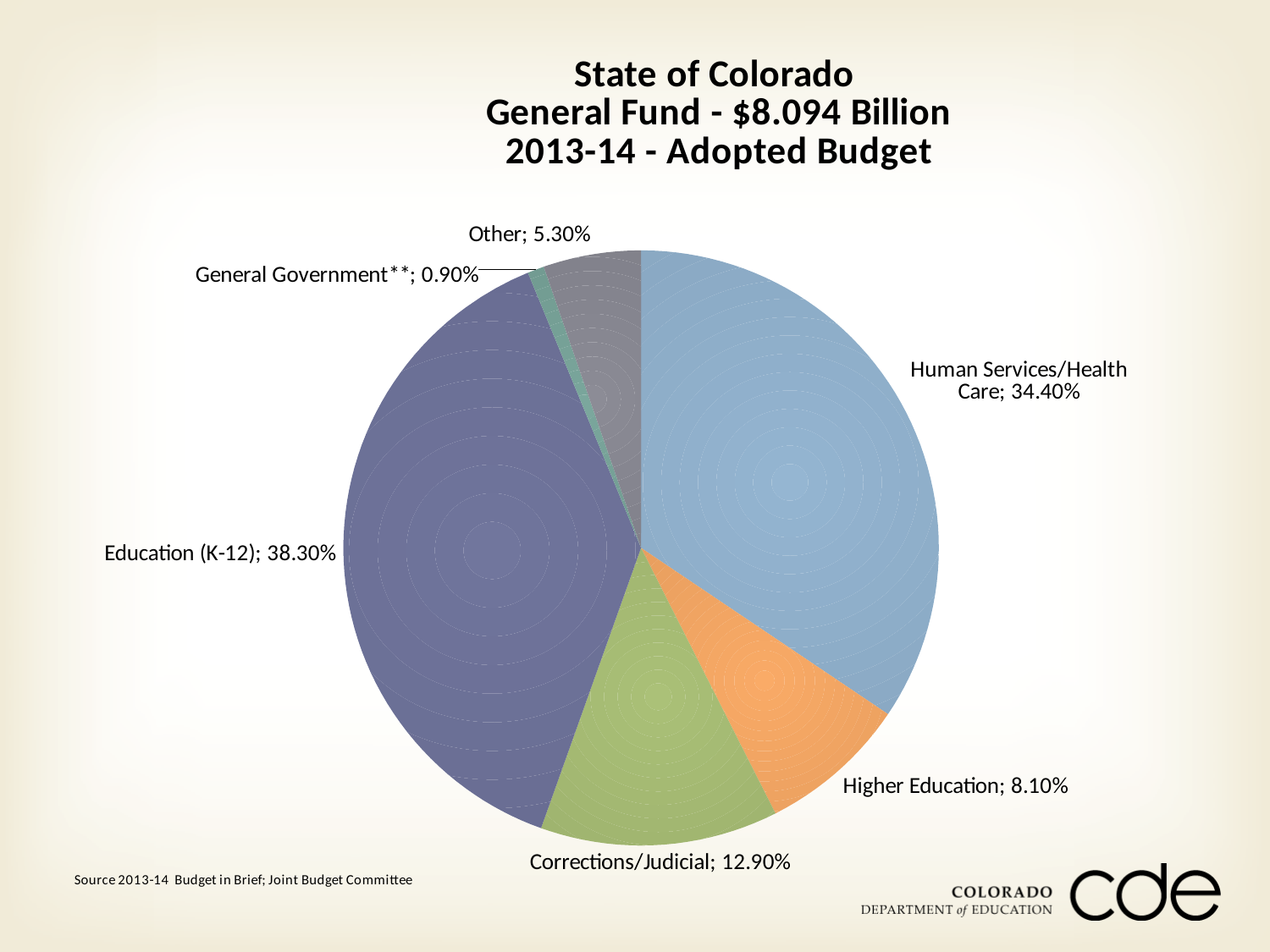
Which category has the largest share of the pie? Education (K-12) What kind of chart is shown on the slide? Pie chart What percentage is shown for Corrections/Judicial? 12.90% What percentage is shown for Higher Education? 8.10% What total General Fund amount is stated in the chart title? $8.094 Billion What is the difference in percentage points between Education (K-12) and Human Services/Health Care? 3.90% What percentage is shown for General Government**? 0.90% What share of the General Fund goes to Human Services/Health Care? 34.40% Which is larger, the share for Corrections/Judicial or the share for Higher Education? Corrections/Judicial What share of the General Fund goes to Education (K-12)? 38.30% How many slices does the pie chart have? 6 Which category has the smallest share of the pie? General Government**